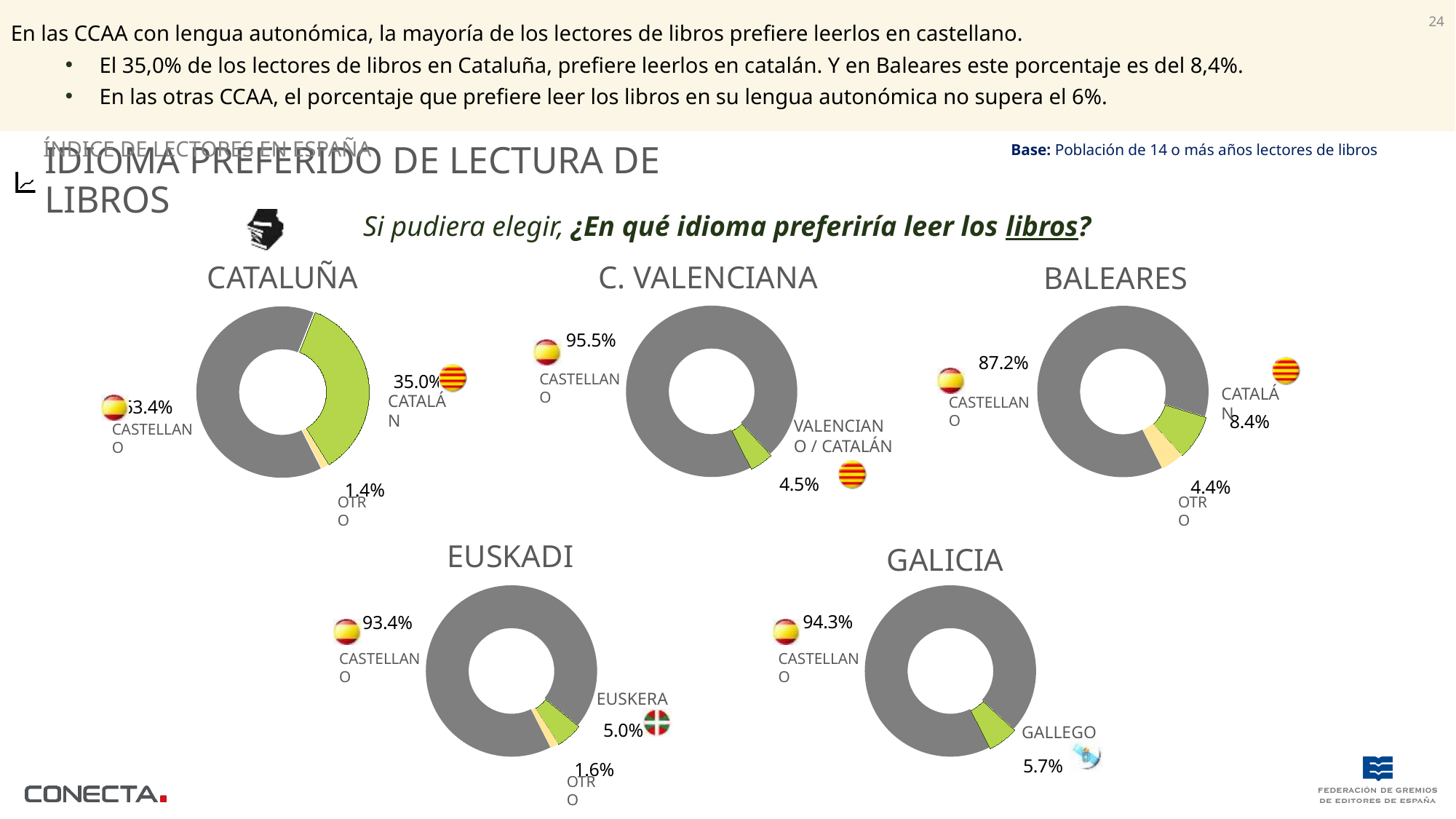
In the Euskadi chart, what percentage of readers prefer Euskera? 5.0% In the Cataluña chart, what percentage corresponds to 'Otro'? 1.4% In the Baleares chart, what is the difference between the Castellano share and the Catalán share? 78.8% In the Galicia chart, which category has the largest share? Castellano In the C. Valenciana chart, what percentage prefer Valenciano / Catalán? 4.5% In the Baleares chart, what percentage of readers prefer Catalán? 8.4% How many donut charts are shown on the slide? 5 In the Galicia chart, what percentage of readers prefer Gallego? 5.7% In the Cataluña chart, what percentage of readers prefer to read books in Catalán? 35.0% In the C. Valenciana chart, what percentage of readers prefer Castellano? 95.5% In the Euskadi chart, which is larger: the share for Euskera or the share for Otro? Euskera What type of chart is used for each region on the slide? Donut (pie) chart